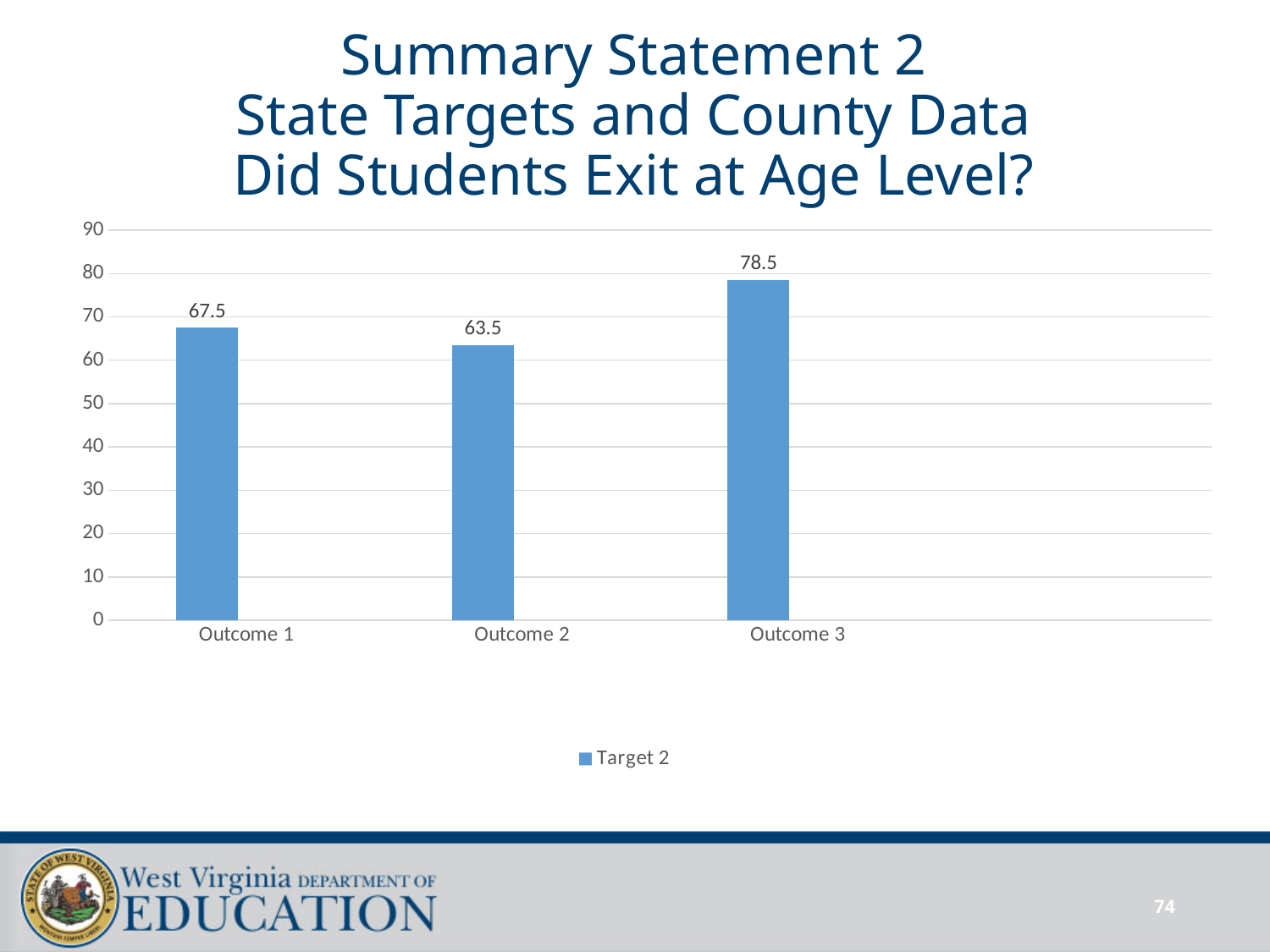
How many outcomes are shown on the chart? 3 What is the Target 2 value for Outcome 2? 63.5 What is the Target 2 value for Outcome 3? 78.5 What kind of chart is shown on the slide? bar chart What is the Target 2 value for Outcome 1? 67.5 Which is larger, the Target 2 value for Outcome 1 or for Outcome 2? Outcome 1 What is the difference between the Target 2 values for Outcome 1 and Outcome 2? 4 What is the difference between the Target 2 values for Outcome 3 and Outcome 1? 11 How many series does the legend list? 1 Which outcome has the highest Target 2 value? Outcome 3 Is the Target 2 value for Outcome 3 greater or less than 70? greater Which outcome has the lowest Target 2 value? Outcome 2